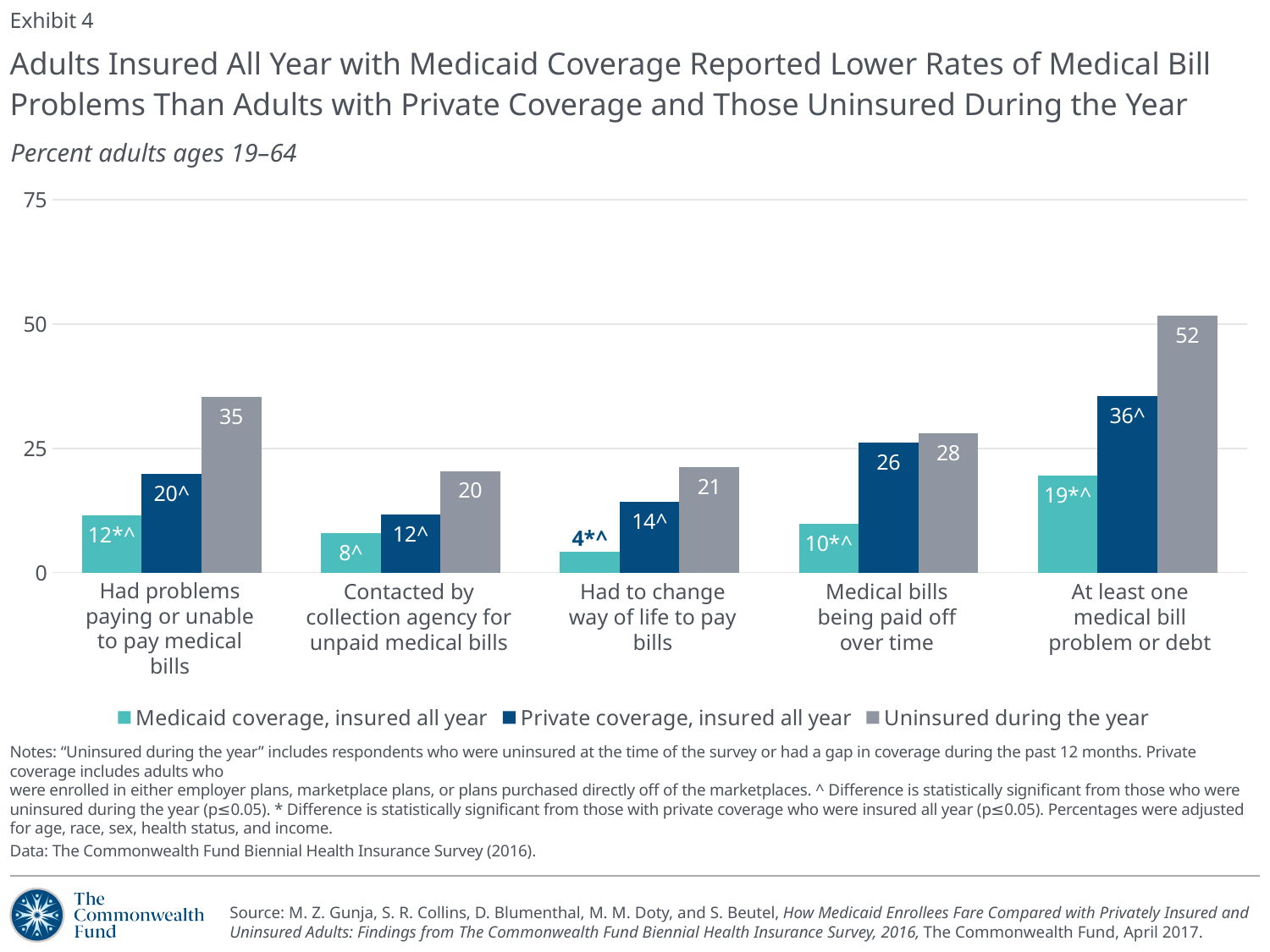
What is the value for Private coverage, insured all year in the 'Medical bills being paid off over time' category? 26 What kind of chart is shown on the slide? Bar chart What is the value for Medicaid coverage, insured all year in the 'Had to change way of life to pay bills' category? 4 What is the difference between the Uninsured during the year value and the Medicaid coverage, insured all year value in the 'Had problems paying or unable to pay medical bills' category? 23 How many series does the legend list? 3 Which category has the highest value for Uninsured during the year? At least one medical bill problem or debt In the 'Contacted by collection agency for unpaid medical bills' category, which is larger: the Private coverage, insured all year value or the Uninsured during the year value? Uninsured during the year What is the value for Uninsured during the year in the 'At least one medical bill problem or debt' category? 52 Is the value for Uninsured during the year in the 'At least one medical bill problem or debt' category greater or less than 50? greater What is the subtitle describing the unit of measurement on the chart? Percent adults ages 19–64 Which category has the lowest value for Medicaid coverage, insured all year? Had to change way of life to pay bills How many categories are shown on the x axis? 5